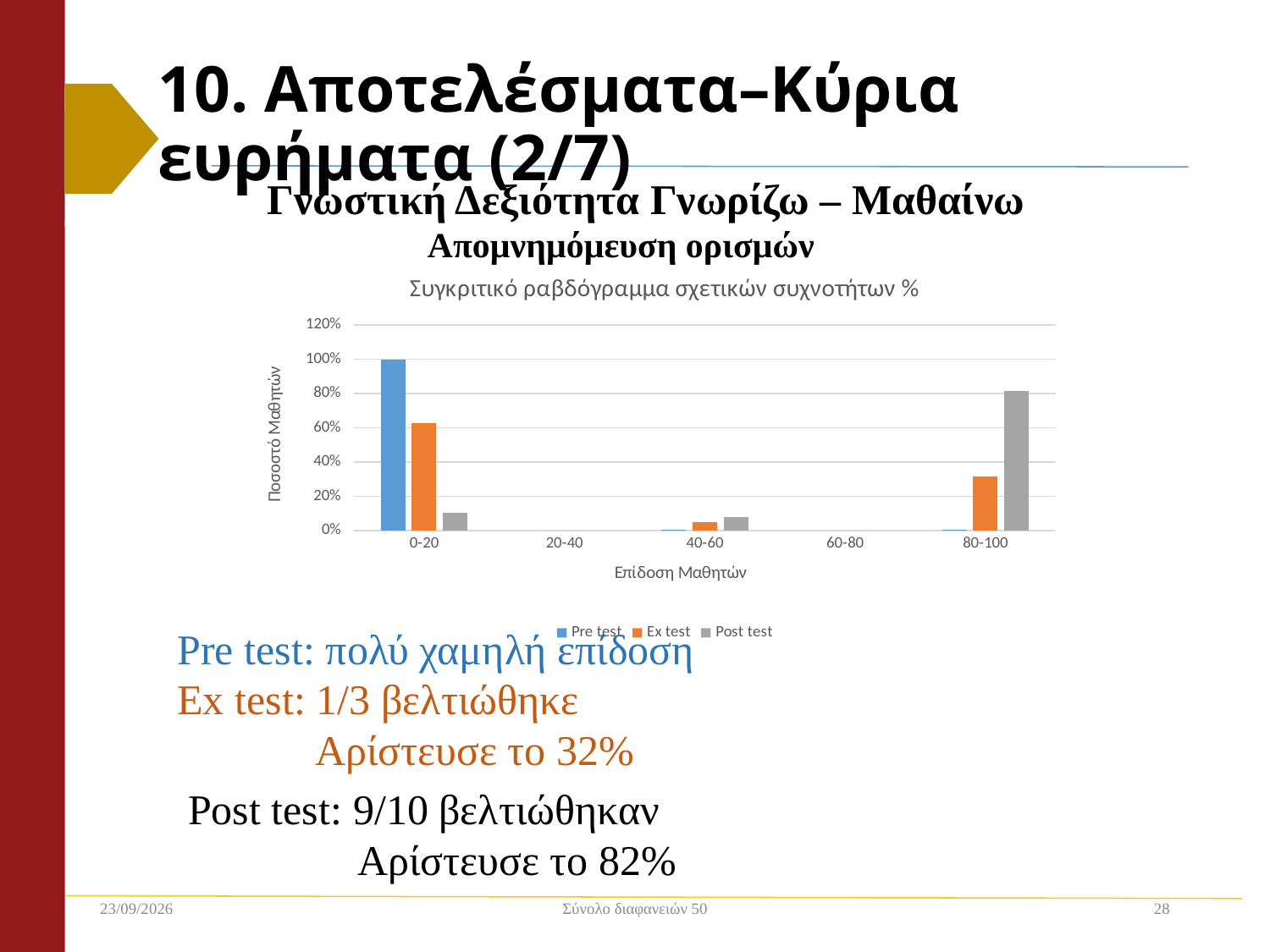
Is the Post test value for the 80-100 category greater or less than 60%? greater Which category has the highest Post test value? 80-100 How many series does the chart legend list? 3 Which category has the highest Ex test value? 0-20 Is the Ex test value for the 80-100 category greater or less than 40%? less In the 0-20 category, which is larger: the Ex test value or the Post test value? Ex test What kind of chart is shown on the slide? bar chart What is the Pre test value for the 0-20 category? 100% How many categories are shown on the x axis of the chart? 5 Which category has the highest Pre test value? 0-20 Is the Ex test value for the 0-20 category greater or less than 40%? greater What is the title of the chart? Συγκριτικό ραβδόγραμμα σχετικών συχνοτήτων %